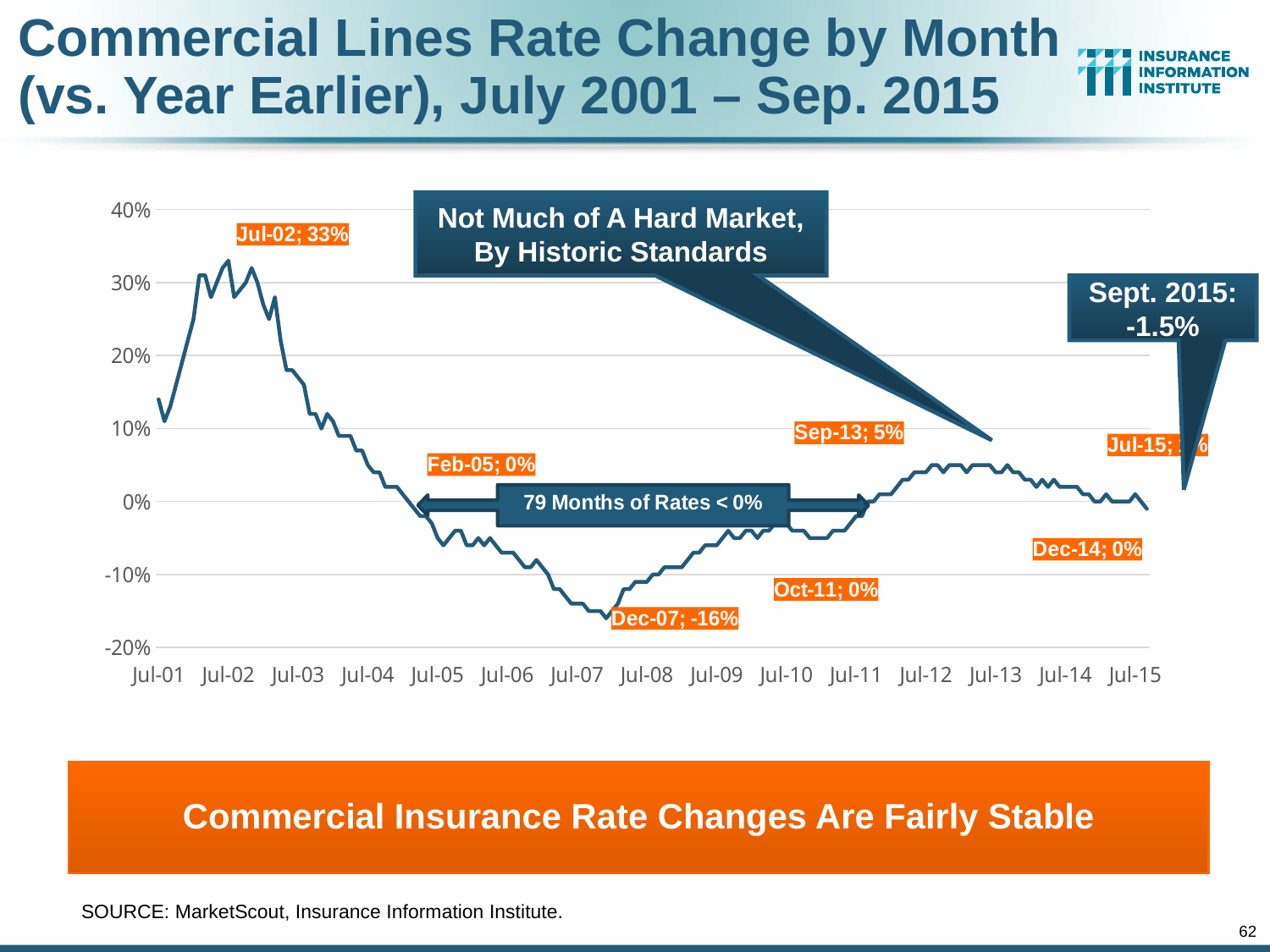
What is the difference in percentage points between the Jul-02 value and the Dec-07 value? 49 percentage points According to the annotation on the chart, for how many months were rates below 0%? 79 months Which labeled month has the highest rate change on the chart? Jul-02 What rate change does the callout give for Sept. 2015? -1.5% Which labeled month has the lowest rate change on the chart? Dec-07 Is the value for Jul-04 greater or less than 10%? less Which is larger, the rate change in Jul-02 or in Sep-13? Jul-02 Does the rate change rise or fall between Jul-02 and Dec-07? fall What was the commercial lines rate change in Dec-07? -16% What was the commercial lines rate change in Jul-02? 33% What was the commercial lines rate change in Sep-13? 5% What kind of chart is shown on the slide? line chart